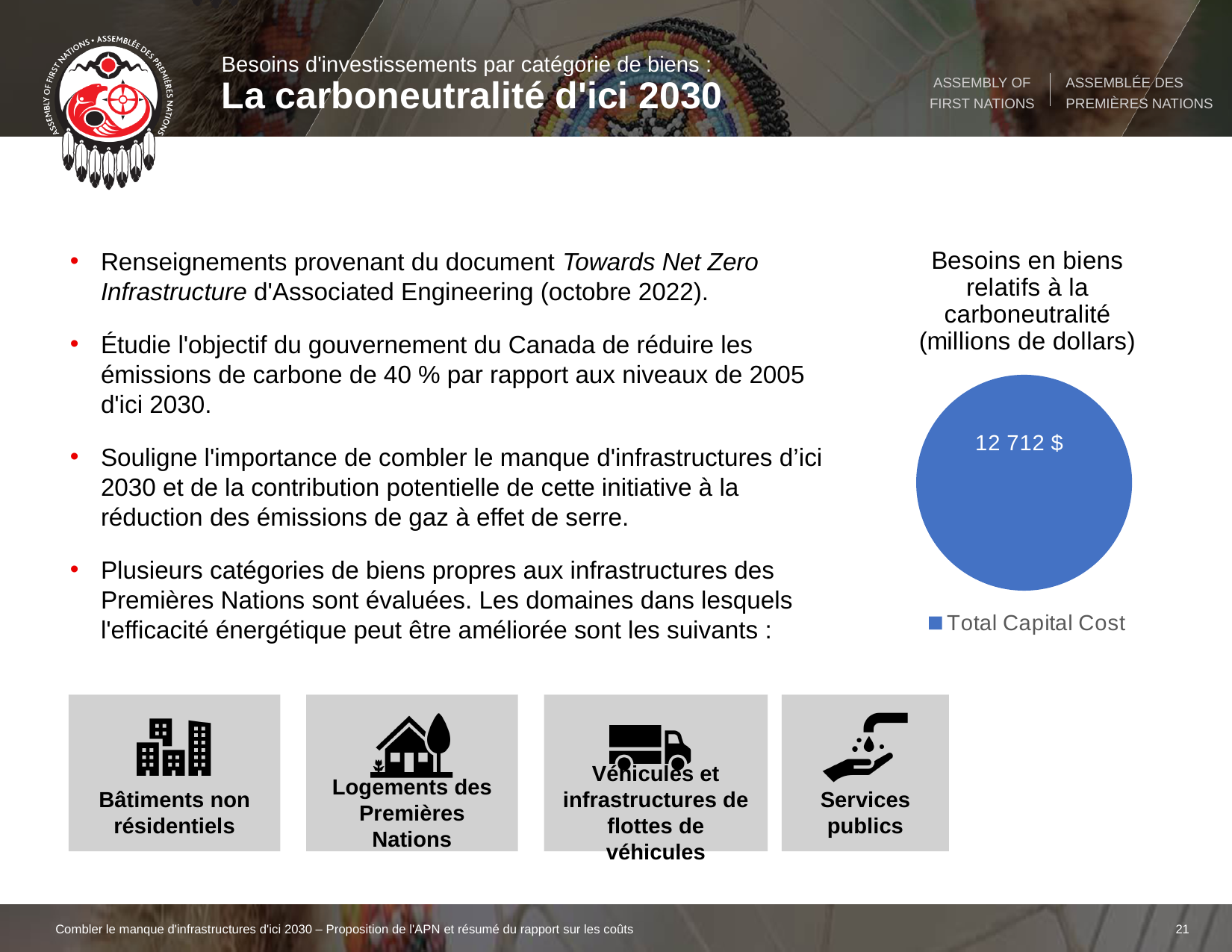
How many series does the chart legend list? 1 What is the legend entry shown below the pie chart? Total Capital Cost What share of the pie does the Total Capital Cost slice represent? 100% How many slices does the pie chart have? 1 What kind of chart is shown on the slide? pie chart What is the title of the pie chart? Besoins en biens relatifs à la carboneutralité (millions de dollars) What value is shown on the pie chart for Total Capital Cost? 12 712 $ In what unit are the values of the pie chart expressed, according to its title? millions de dollars